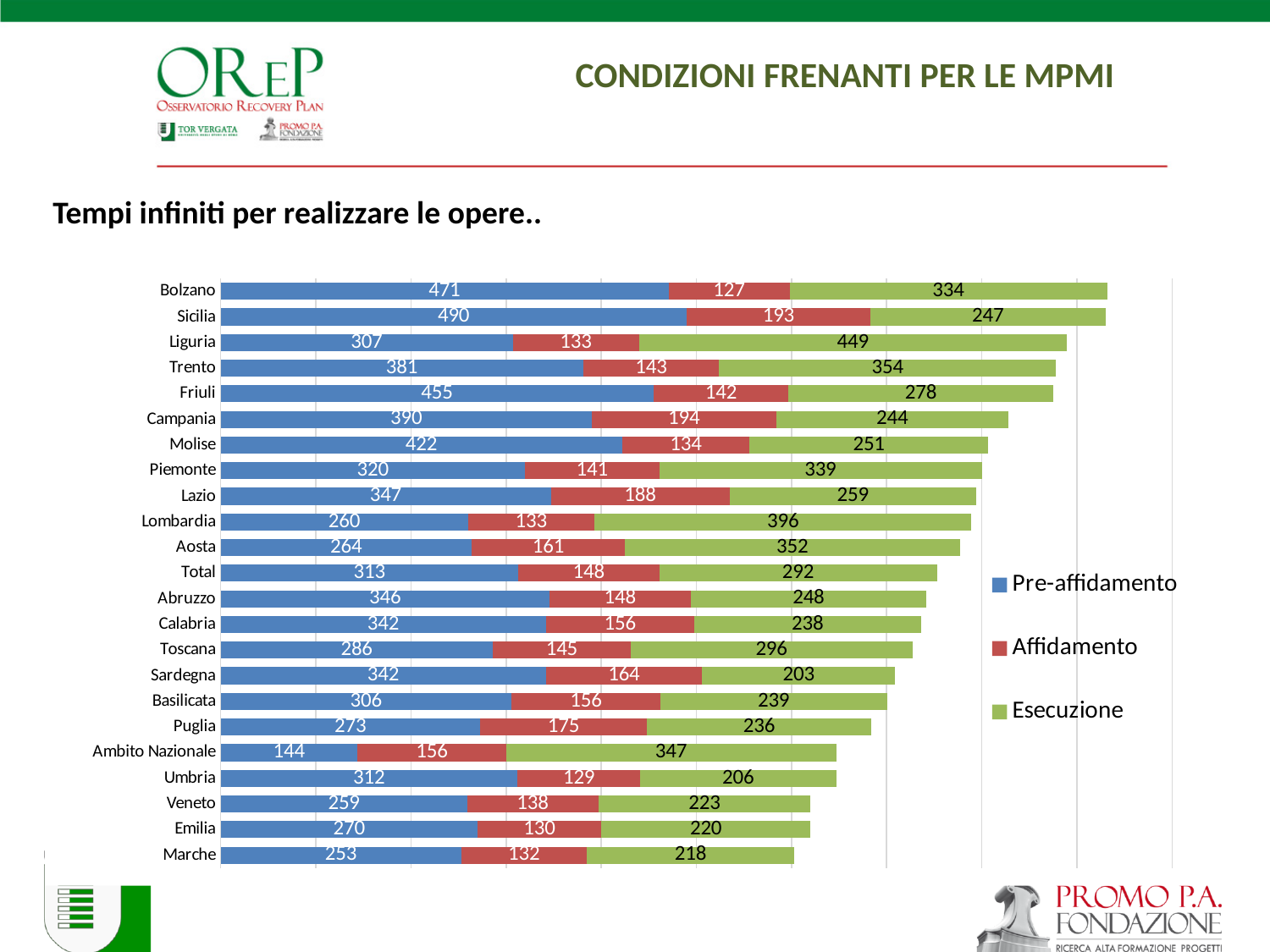
What is the total of the stacked bar for Bolzano? 932 What is the Pre-affidamento value for Sicilia? 490 For Lombardia, which is larger: the Pre-affidamento value or the Esecuzione value? Esecuzione How many categories are shown on the chart? 23 What type of chart is shown on the slide? Stacked bar chart Which category has the lowest Esecuzione value? Sardegna What is the Esecuzione value for Liguria? 449 Which category has the highest Pre-affidamento value? Sicilia What is the Affidamento value for Ambito Nazionale? 156 What is the difference between the Esecuzione values for Liguria and Bolzano? 115 Which category has the lowest Pre-affidamento value? Ambito Nazionale How many series does the legend list? 3